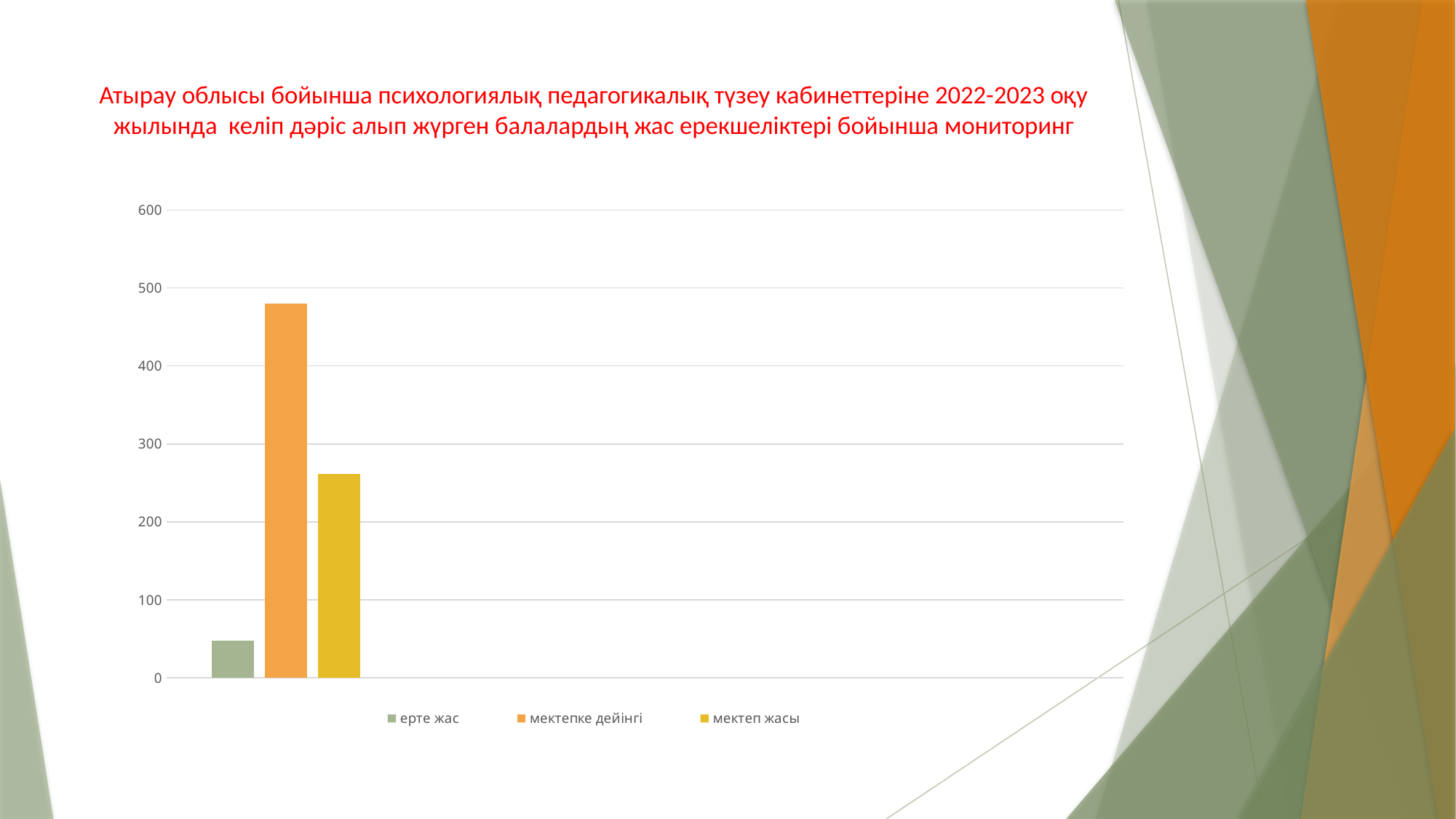
What kind of chart is shown on the slide? bar chart Which series has the lowest bar? ерте жас Is the value for ерте жас greater or less than 100? less Which is larger, the value for мектепке дейінгі or the value for мектеп жасы? мектепке дейінгі Is the value for мектепке дейінгі greater or less than 500? less Is the value for мектеп жасы greater or less than 200? greater Which is larger, the value for мектеп жасы or the value for ерте жас? мектеп жасы What colour is the bar for мектепке дейінгі? orange What is the highest value shown on the vertical axis? 600 How many series does the legend list? 3 Which series has the highest bar? мектепке дейінгі